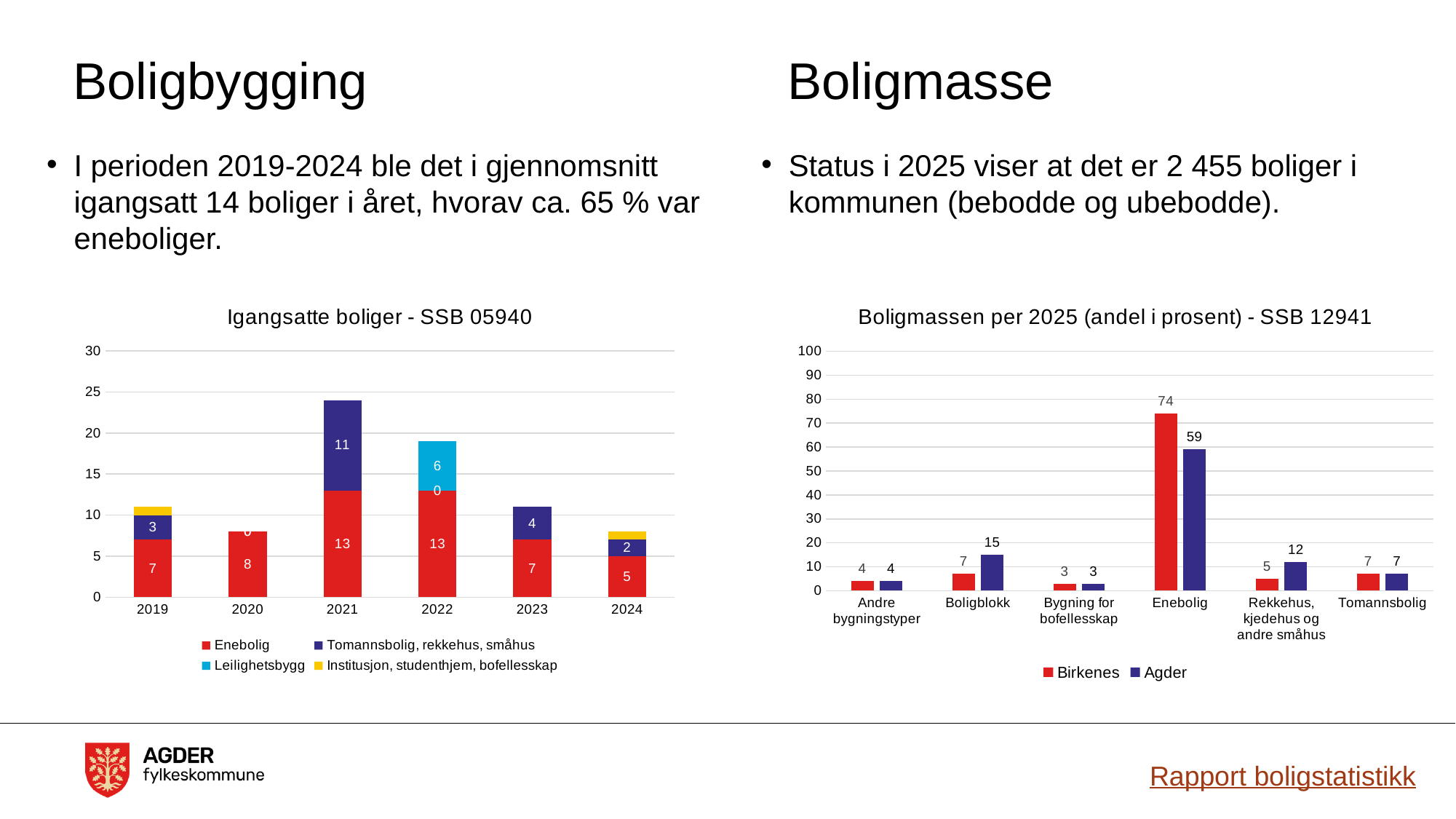
In the chart 'Igangsatte boliger - SSB 05940', what is the Enebolig value for 2021? 13 In the chart 'Boligmassen per 2025 (andel i prosent) - SSB 12941', what is the Birkenes value for Enebolig? 74 In the chart 'Igangsatte boliger - SSB 05940', how many years are shown on the x axis? 6 In the chart 'Boligmassen per 2025 (andel i prosent) - SSB 12941', what is the Agder value for Boligblokk? 15 In the chart 'Boligmassen per 2025 (andel i prosent) - SSB 12941', what is the difference between the Birkenes and Agder values for Enebolig? 15 In the chart 'Igangsatte boliger - SSB 05940', how many series does the legend list? 4 In the chart 'Boligmassen per 2025 (andel i prosent) - SSB 12941', which category has the highest Birkenes value? Enebolig In the chart 'Igangsatte boliger - SSB 05940', what is the Leilighetsbygg value for 2022? 6 In the chart 'Boligmassen per 2025 (andel i prosent) - SSB 12941', which is larger for Rekkehus, kjedehus og andre småhus: Birkenes or Agder? Agder In the chart 'Igangsatte boliger - SSB 05940', what is the total of the stacked bar for 2021? 24 What kind of chart is 'Boligmassen per 2025 (andel i prosent) - SSB 12941'? Bar chart In the chart 'Igangsatte boliger - SSB 05940', what is the value for Tomannsbolig, rekkehus, småhus in 2023? 4